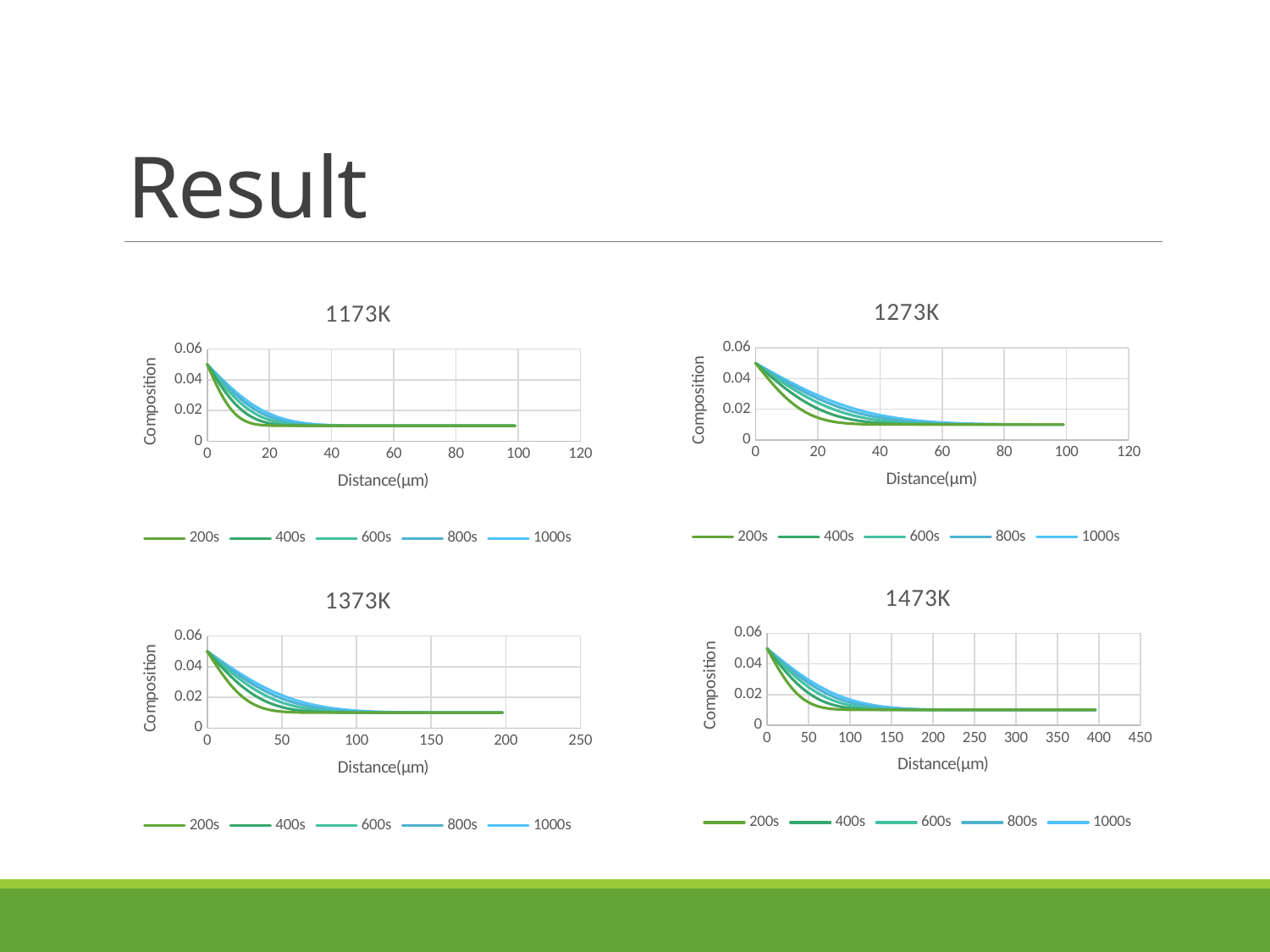
In the chart titled 1473K, what is the largest tick value shown on the x axis? 450 What kind of chart is the chart titled 1173K? line chart What kind of chart is the chart titled 1473K? line chart In the chart titled 1173K, is the composition at distance 0 greater or less than 0.04? greater In the chart titled 1273K, is the composition of the 200s series at a distance of 80 μm greater or less than 0.02? less In the chart titled 1173K, does the composition rise or fall along the x axis between 0 and 20 μm? fall How many charts are shown on the slide? 4 In the chart titled 1373K, does the composition rise or fall as distance increases from 0? fall In the chart titled 1373K, which series is listed last in the legend? 1000s In the chart titled 1473K, is the composition of the 1000s series at a distance of 300 μm greater or less than 0.02? less What is the label of the y axis on the chart titled 1473K? Composition How many series does the legend of the chart titled 1273K list? 5